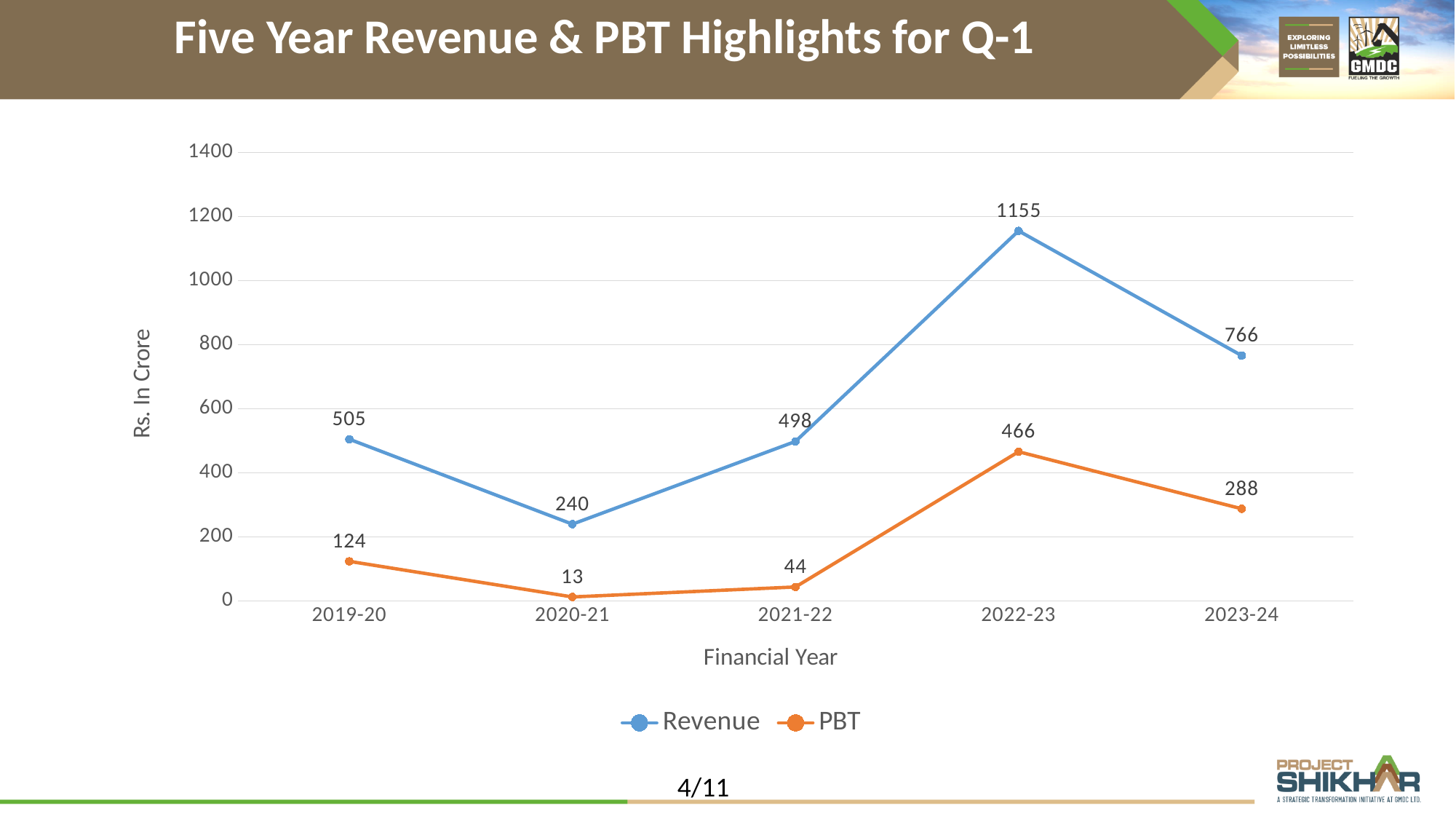
Is the PBT value for 2022-23 greater or less than 400? greater How many series does the legend list? 2 What is the difference between Revenue and PBT in 2023-24? 478 How many financial years are shown on the x axis? 5 Which financial year has the highest Revenue? 2022-23 What is the Revenue value for 2019-20? 505 What is the label of the y axis? Rs. In Crore Which financial year has the lowest PBT? 2020-21 What kind of chart is shown on the slide? Line chart What is the PBT value for 2020-21? 13 Which is larger, the Revenue for 2019-20 or the Revenue for 2021-22? Revenue for 2019-20 What is the Revenue value for 2022-23? 1155